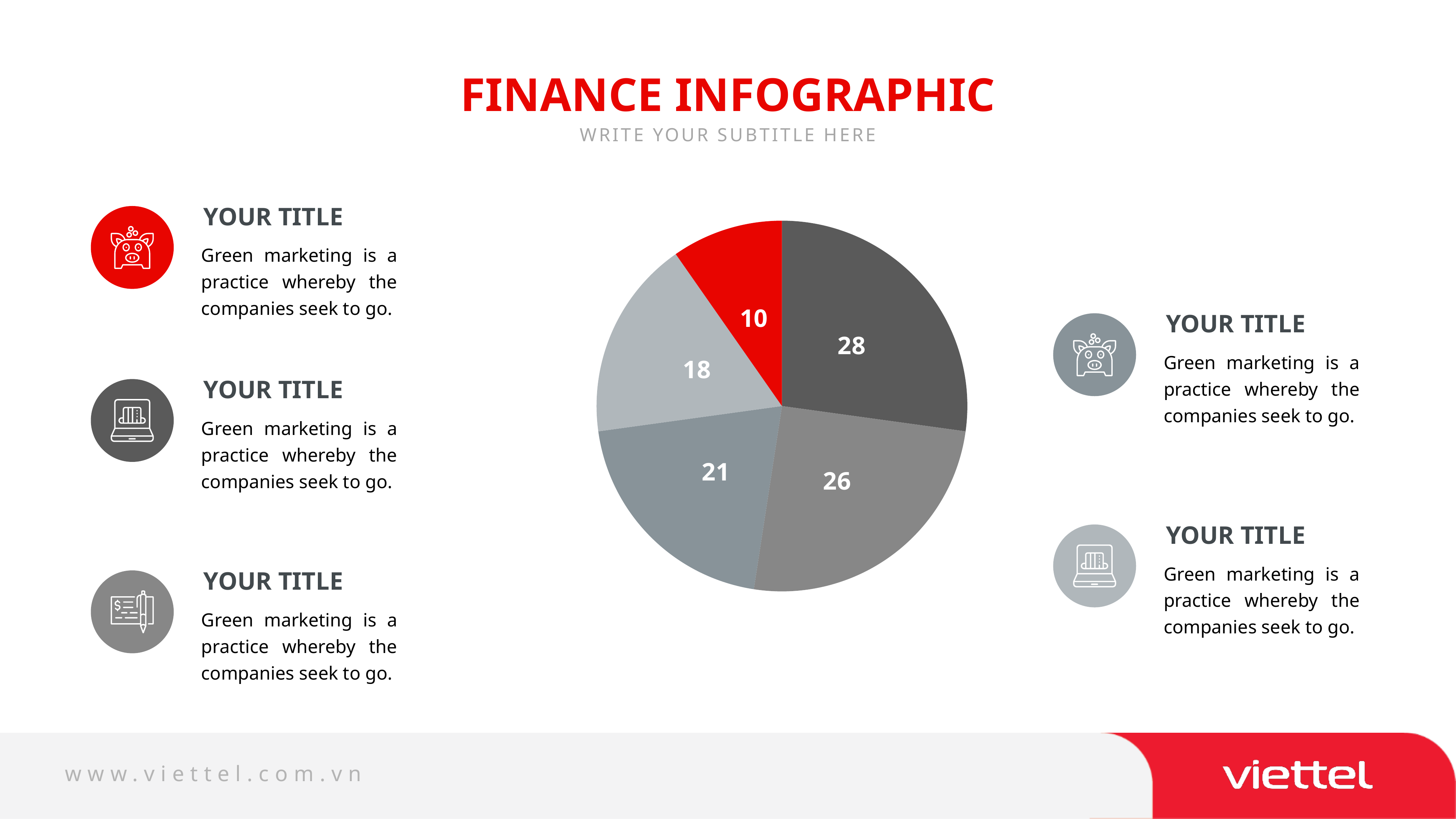
What is the largest value shown in the pie chart? 28 What kind of chart is shown on the slide? pie chart What is the difference between the largest slice value (28) and the smallest slice value (10) in the pie chart? 18 What value is shown on the darkest grey slice of the pie chart? 28 What value is shown on the red slice of the pie chart? 10 How many slices does the pie chart have? 5 What value is shown on the lightest grey slice of the pie chart? 18 What is the sum of all the slice values shown in the pie chart? 103 What is the difference between the slice labelled 26 and the slice labelled 21? 5 What is the smallest value shown in the pie chart? 10 What is the title of the slide containing the pie chart? FINANCE INFOGRAPHIC Which is larger in the pie chart: the red slice or the lightest grey slice? the lightest grey slice